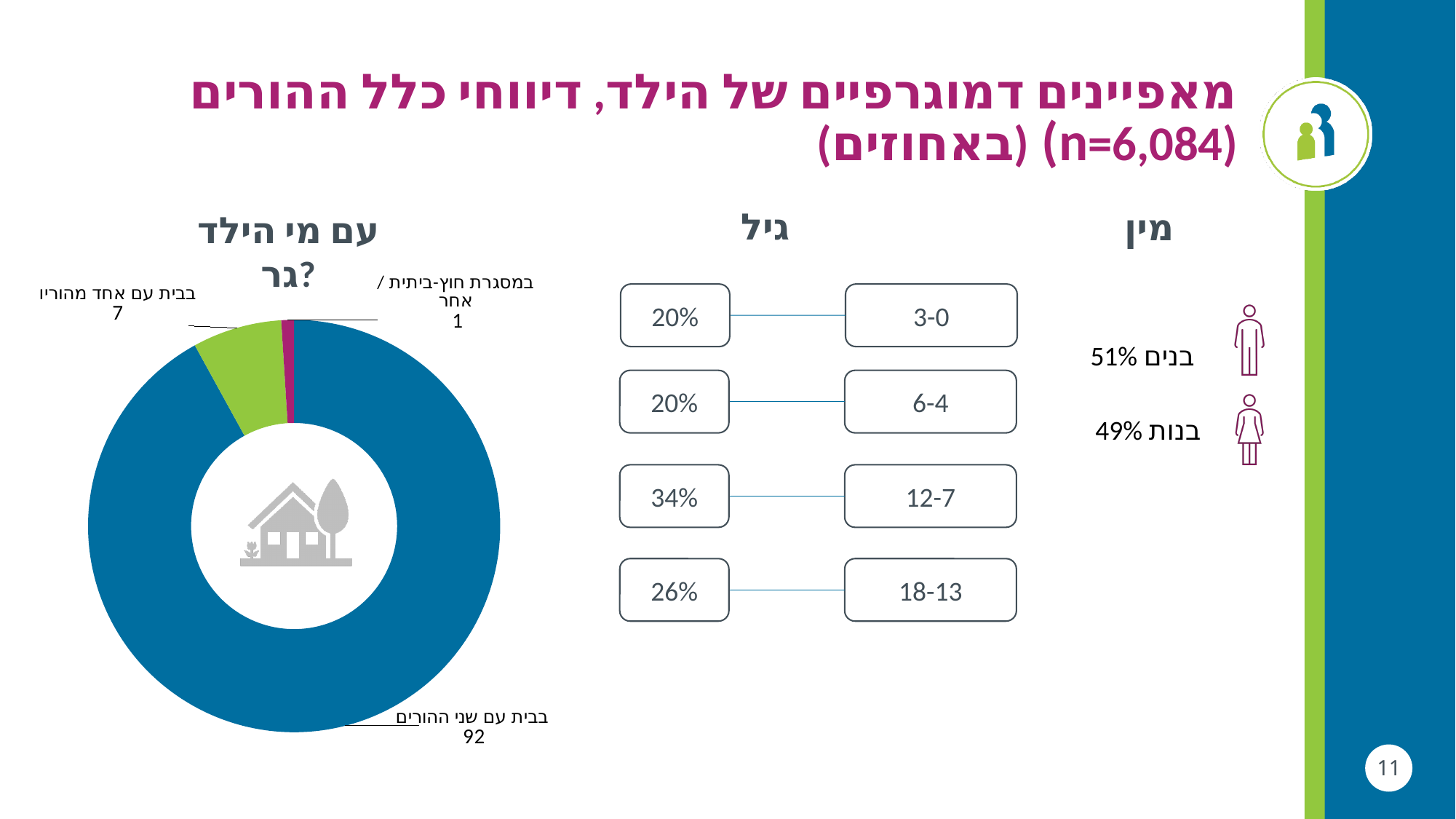
In the chart "עם מי הילד גר?", what is the difference between the values for "בבית עם שני ההורים" and "בבית עם אחד מהוריו"? 85 In the chart "עם מי הילד גר?", what is the value for "בבית עם שני ההורים"? 92 In the chart "עם מי הילד גר?", what is the value for "במסגרת חוץ-ביתית / אחר"? 1 In the chart "עם מי הילד גר?", what colour is the largest slice? blue In the chart "עם מי הילד גר?", which category has the highest value? בבית עם שני ההורים In the chart "עם מי הילד גר?", which is larger: "בבית עם אחד מהוריו" or "במסגרת חוץ-ביתית / אחר"? בבית עם אחד מהוריו In the chart "עם מי הילד גר?", what share of the pie does "בבית עם שני ההורים" take? 92% In the chart "עם מי הילד גר?", what is the value for "בבית עם אחד מהוריו"? 7 How many categories (slices) does the chart "עם מי הילד גר?" show? 3 In the chart "עם מי הילד גר?", which category has the lowest value? במסגרת חוץ-ביתית / אחר What is the title of the pie chart on the left of the slide? עם מי הילד גר? What kind of chart is the chart titled "עם מי הילד גר?"? pie (doughnut) chart